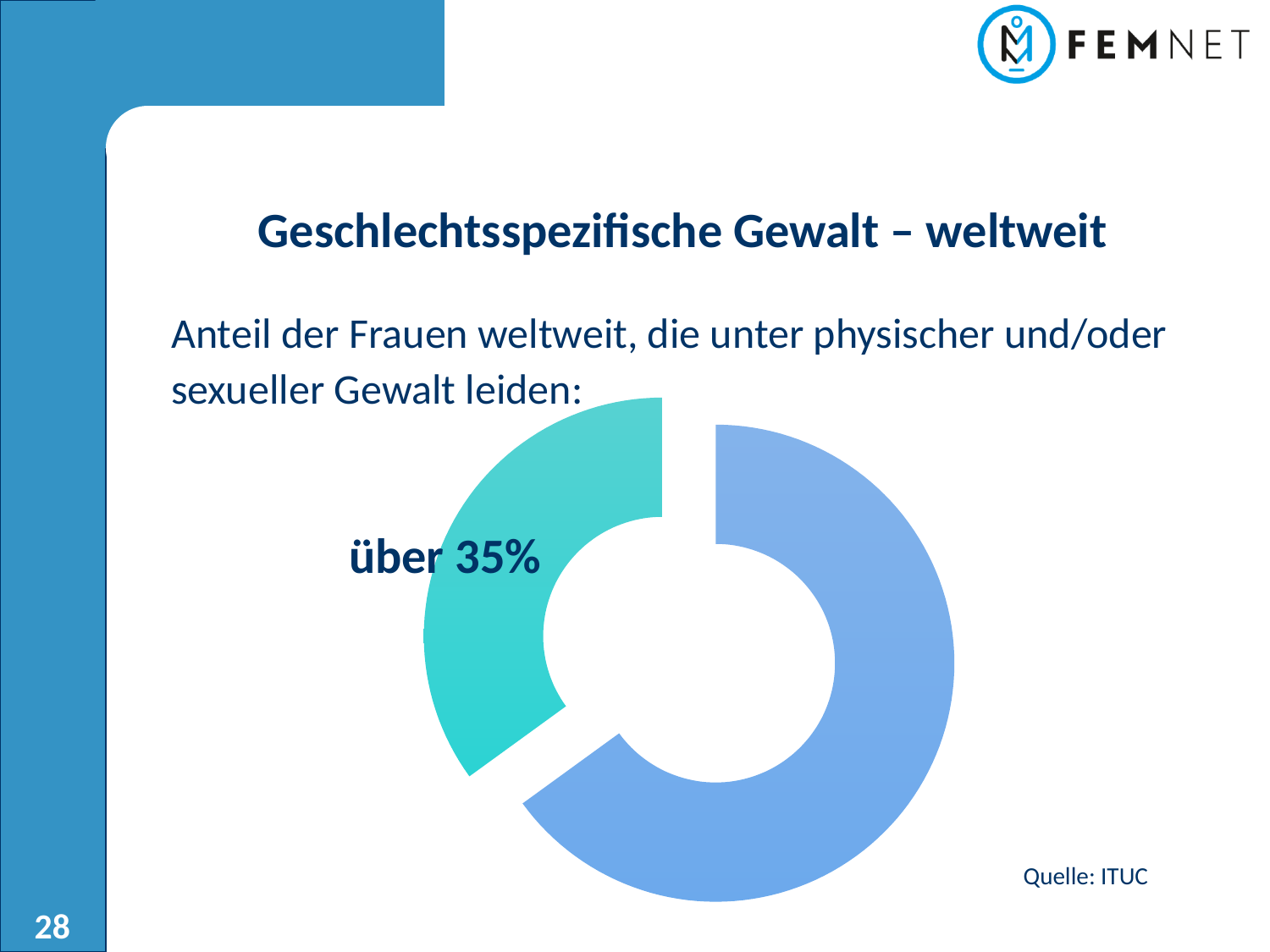
What source is cited for the doughnut chart? ITUC What is the title of the slide containing the doughnut chart? Geschlechtsspezifische Gewalt – weltweit How many slices does the doughnut chart have? 2 Which slice of the doughnut chart is the smallest? the teal slice (über 35%) Which slice of the doughnut chart is the largest? the blue slice What kind of chart is shown on the slide? doughnut chart Which slice of the doughnut chart is larger, the teal one or the blue one? the blue one What share is printed next to the teal slice of the doughnut chart? über 35%